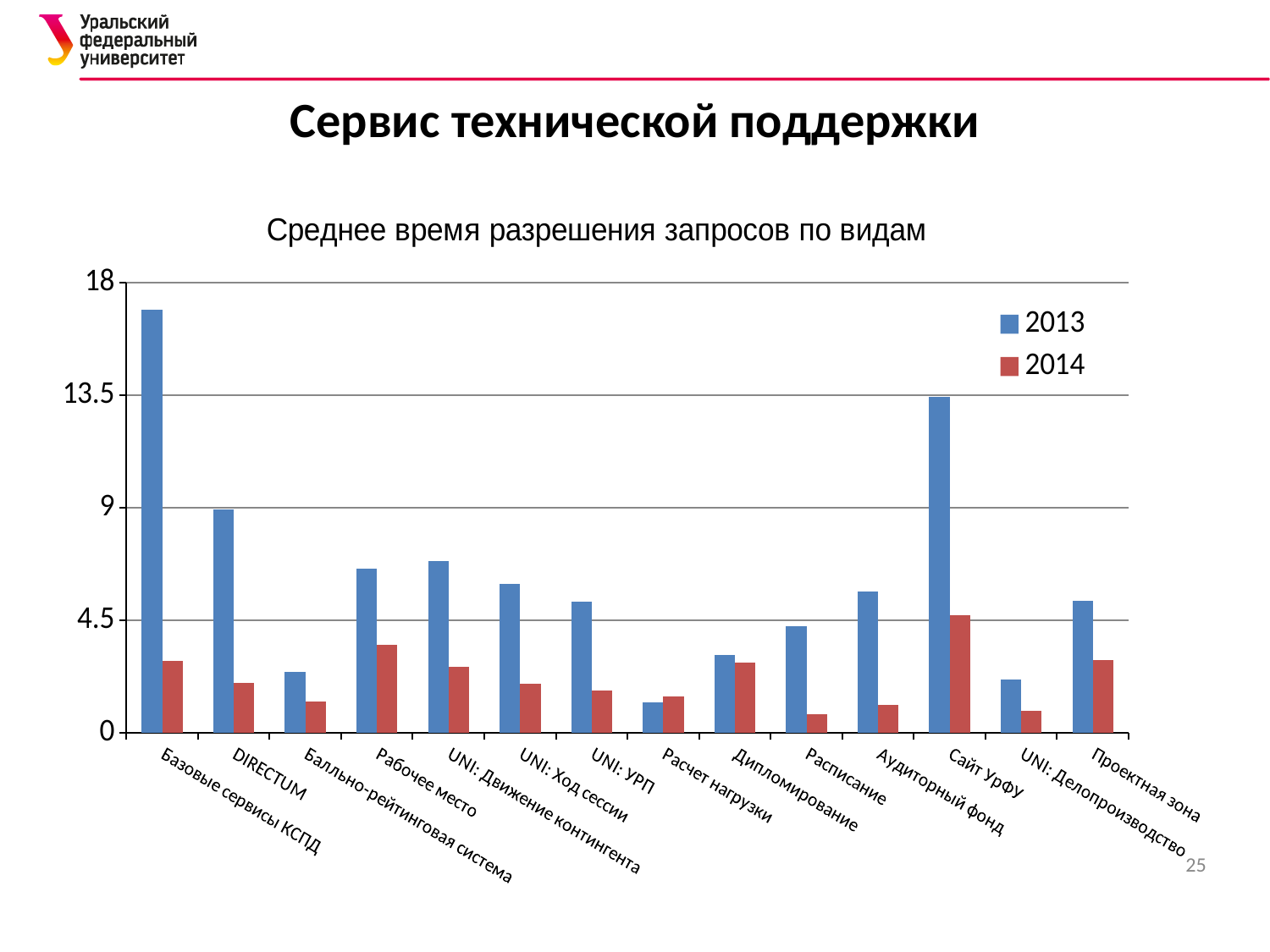
Which category has the highest value for 2014? Сайт УрФУ Which category has the lowest value for 2013? Расчет нагрузки Is the 2014 value for Рабочее место greater or less than 4.5? less Which category has the highest value for 2013? Базовые сервисы КСПД How many categories are shown on the x axis? 14 Is the 2013 value for Базовые сервисы КСПД greater or less than 13.5? greater For Аудиторный фонд, which is larger: the 2013 value or the 2014 value? 2013 What type of chart is shown on the slide? bar chart Which category has the lowest value for 2014? Расписание What is the title of the chart? Среднее время разрешения запросов по видам Is the 2013 value for Сайт УрФУ greater or less than 9? greater How many series does the legend list? 2